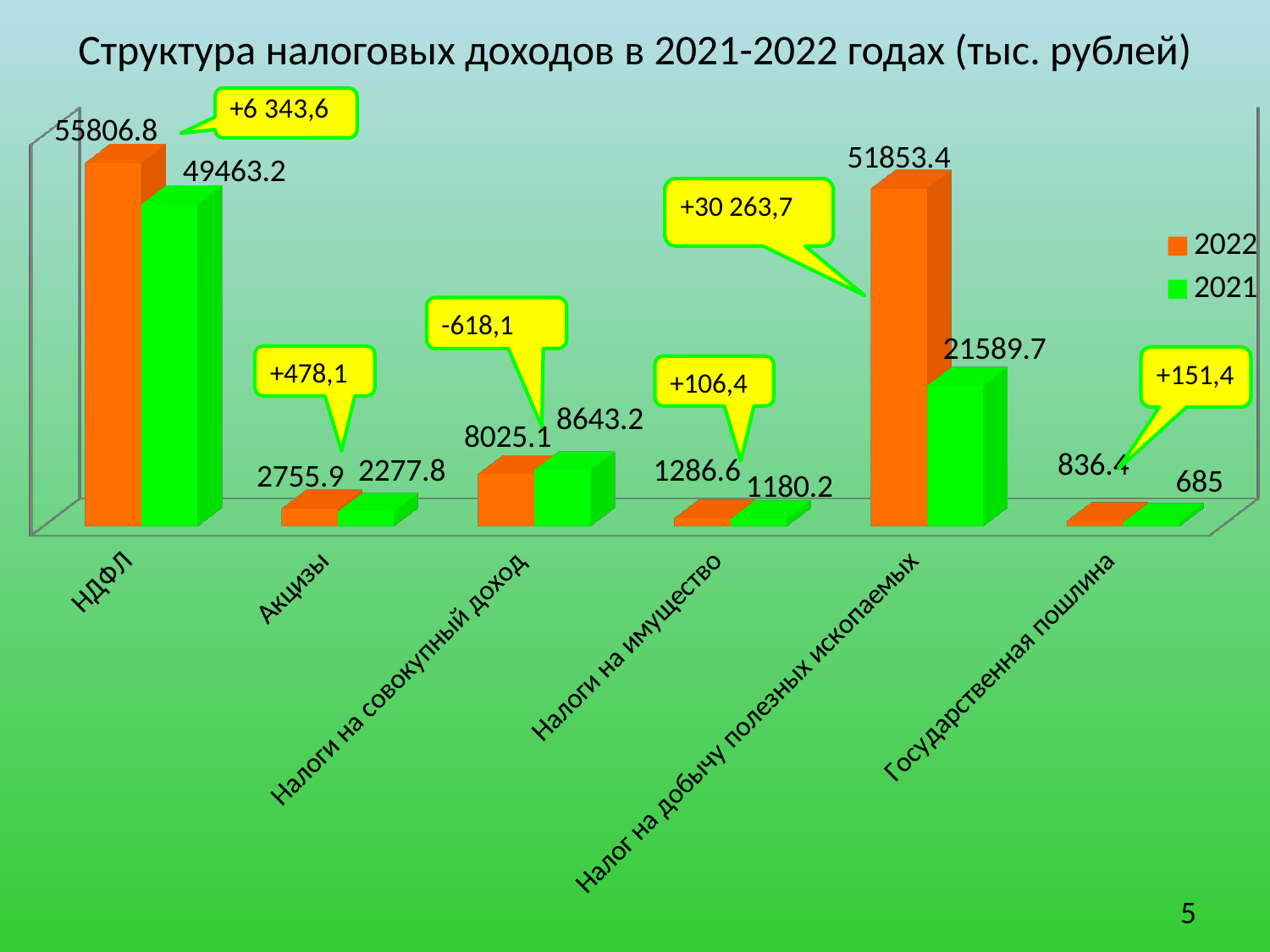
How many categories are shown on the x axis? 6 What is the value for НДФЛ in 2022? 55806.8 What is the value for Налог на добычу полезных ископаемых in 2021? 21589.7 What is the value for Акцизы in 2021? 2277.8 How many series does the legend list? 2 Which category has the highest value in 2022? НДФЛ What is the difference between the 2022 and 2021 values for Налог на добычу полезных ископаемых? 30263.7 What is the value for Налоги на совокупный доход in 2022? 8025.1 Which category has the lowest value in 2021? Государственная пошлина What kind of chart is shown on the slide? Bar chart Which is larger for Налоги на совокупный доход: the 2022 value or the 2021 value? 2021 What is the value for Государственная пошлина in 2021? 685